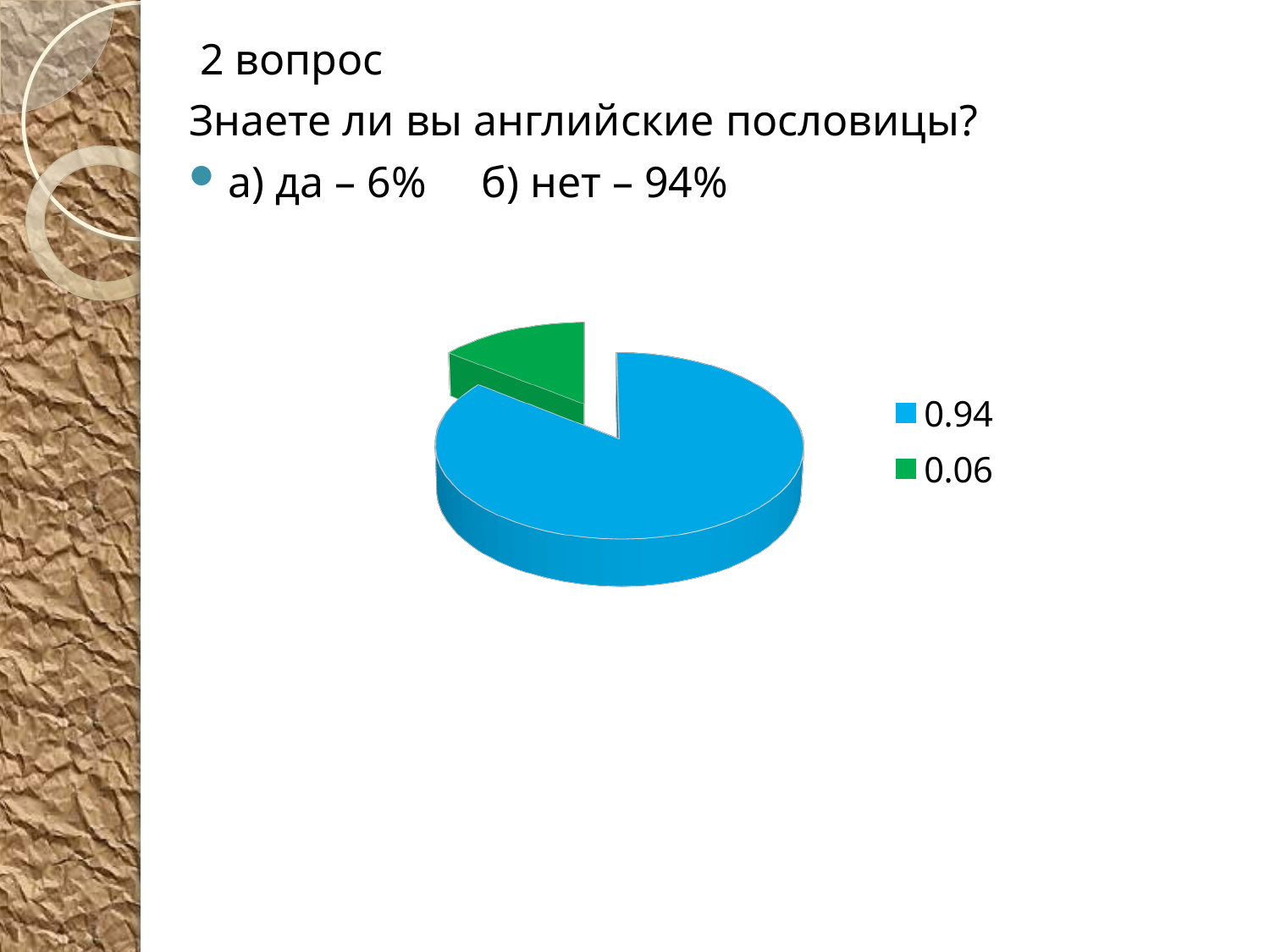
How many entries does the legend of the pie chart list? 2 What kind of chart is shown on the slide? pie chart What legend label is shown for the blue slice of the pie chart? 0.94 How many slices does the pie chart have? 2 What colour is the slice labelled 0.06 in the pie chart? green Which legend entry corresponds to the smaller slice of the pie chart? 0.06 What colour is the slice labelled 0.94 in the pie chart? blue Which legend entry corresponds to the larger slice of the pie chart? 0.94 Which slice is larger in the pie chart, the blue one or the green one? the blue one What legend label is shown for the green slice of the pie chart? 0.06